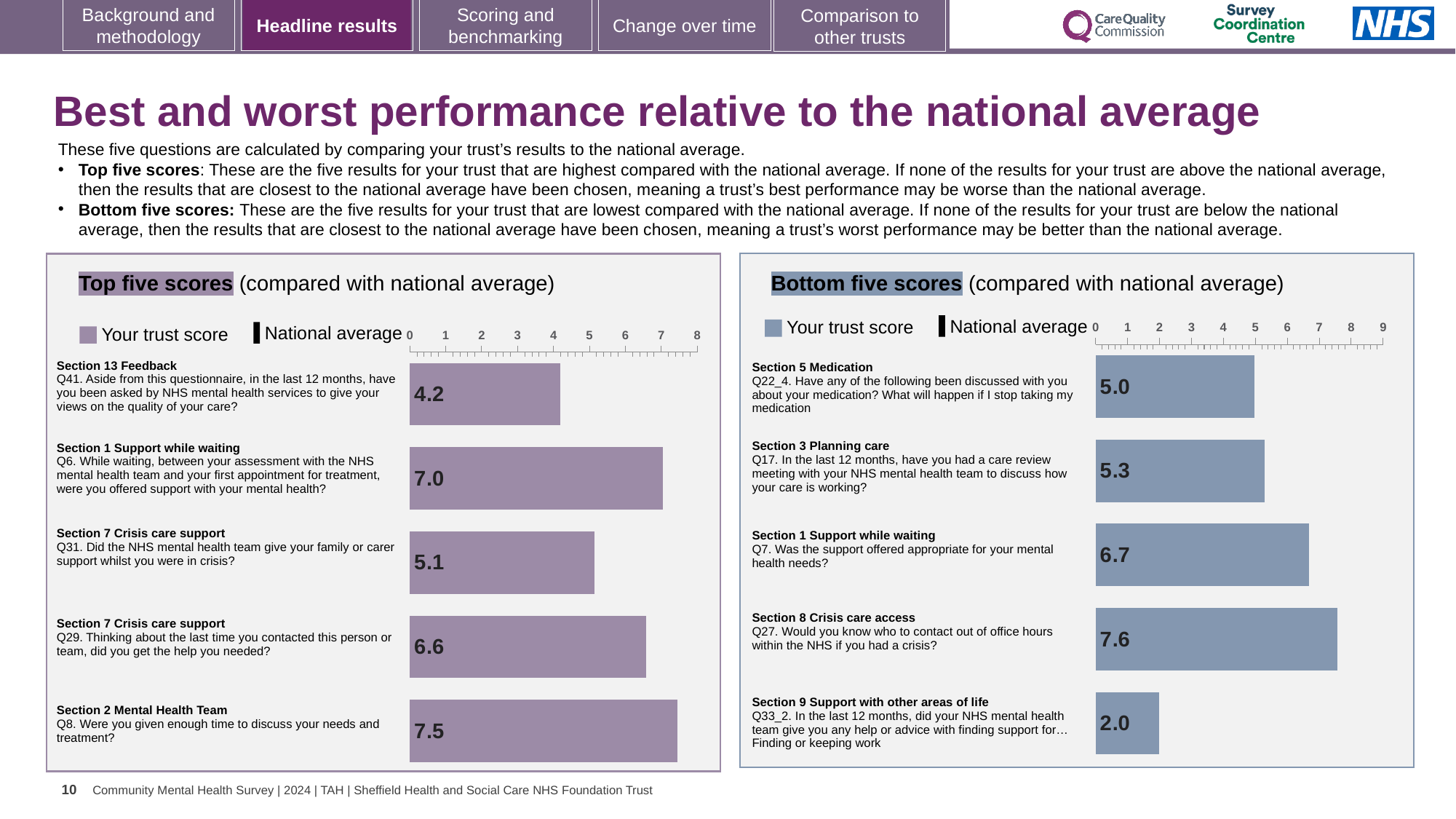
In the Bottom five scores chart, which has the larger trust score, Q22_4 or Q17? Q17 In the Top five scores chart, what is the trust score for Q8 (Were you given enough time to discuss your needs and treatment?)? 7.5 In the Top five scores chart, which question has the highest trust score? Q8 In the Bottom five scores chart, what is the trust score for Q27 (Would you know who to contact out of office hours within the NHS if you had a crisis?)? 7.6 In the Top five scores chart, what is the trust score for Q41 (Aside from this questionnaire, in the last 12 months, have you been asked by NHS mental health services to give your views on the quality of your care?)? 4.2 In the Bottom five scores chart, which question has the lowest trust score? Q33_2 What type of chart is the Top five scores chart? Bar chart In the Top five scores chart, is the trust score for Q29 greater or less than 6? greater What two entries does the legend of the Bottom five scores chart list? Your trust score and National average In the Bottom five scores chart, what is the trust score for Q33_2 (Finding or keeping work)? 2.0 In the Top five scores chart, what is the difference between the trust scores for Q6 and Q31? 1.9 How many bars are plotted in the Bottom five scores chart? 5